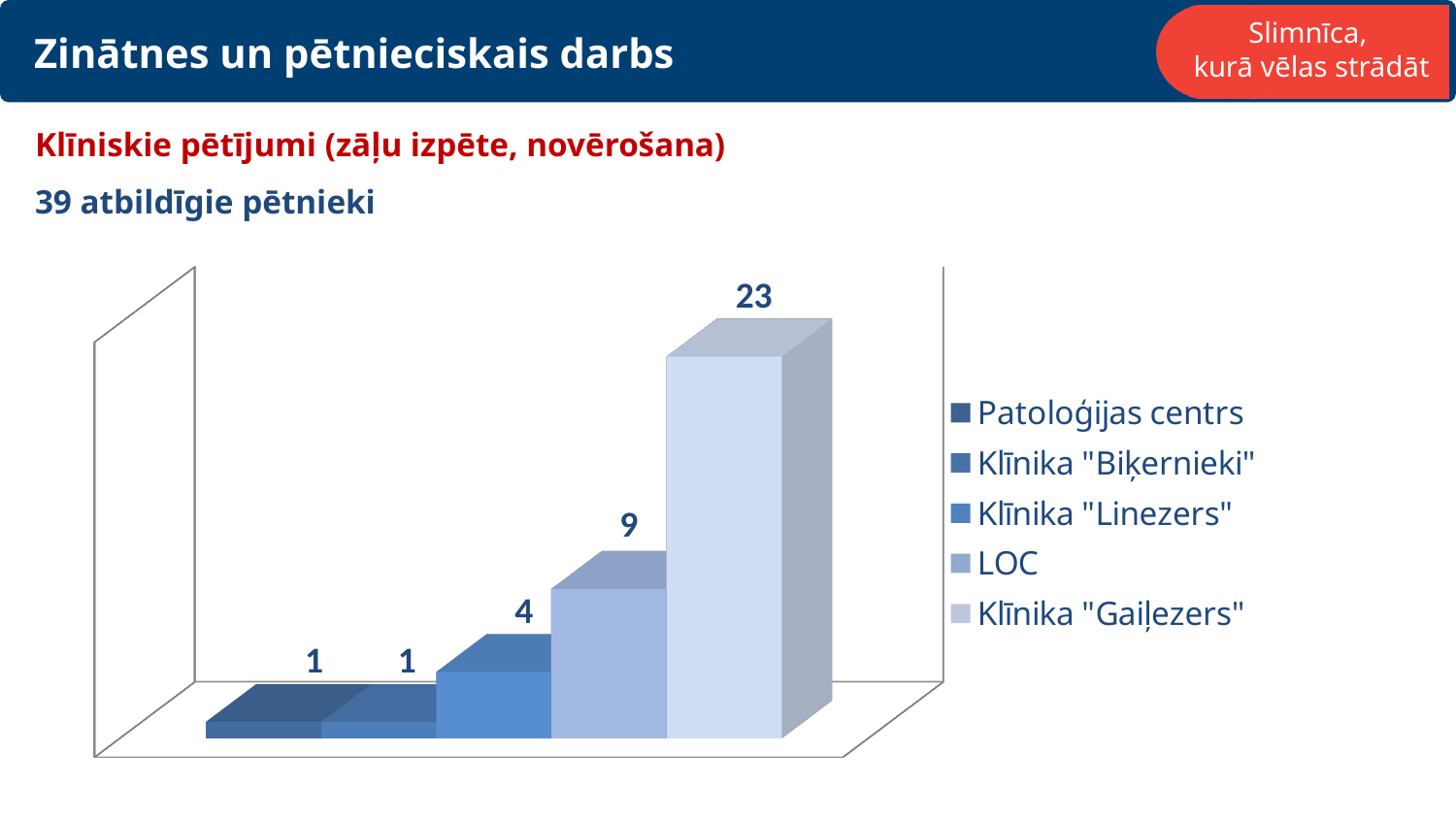
Which legend entry has the highest value? Klīnika "Gaiļezers" How many bars are plotted in the chart? 5 What is the difference between the values for LOC and Klīnika "Linezers"? 5 What value is shown for LOC? 9 What value is shown for Patoloģijas centrs? 1 What is the difference between the values for Klīnika "Gaiļezers" and LOC? 14 How many entries does the legend list? 5 What value is shown for Klīnika "Gaiļezers"? 23 Do the bar values rise or fall from left to right? rise What kind of chart is shown on the slide? bar chart What value is shown for Klīnika "Linezers"? 4 Which is larger, the value for LOC or the value for Klīnika "Linezers"? LOC